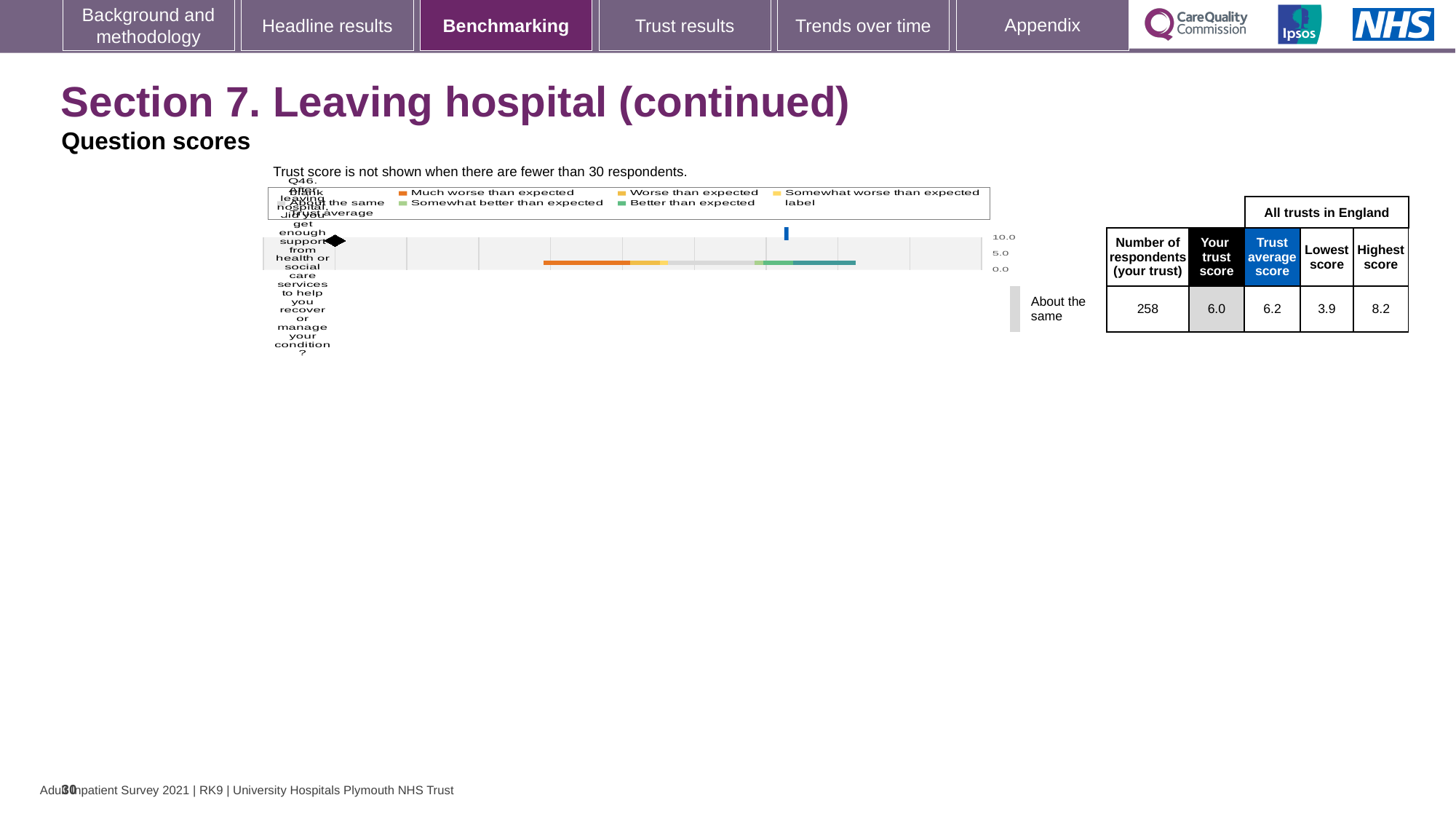
What is the lowest score for Q46 among all trusts in England? 3.9 What is the trust's score for Q46 shown in the table? 6.0 What is the difference between the highest and lowest scores for Q46 across all trusts in England? 4.3 What benchmarking category is the trust's Q46 result placed in? About the same What is the highest score for Q46 among all trusts in England? 8.2 What is the maximum value shown on the chart's score axis? 10.0 What kind of chart is used to show the Q46 benchmarking result? Bar chart How many respondents from the trust answered Q46? 258 Which is larger for Q46: the trust's own score or the trust average score? Trust average score How many questions are plotted on the benchmarking chart? 1 What is the trust average score for Q46 across all trusts in England? 6.2 Is the trust's score for Q46 greater or less than 5.0 on the chart axis? greater